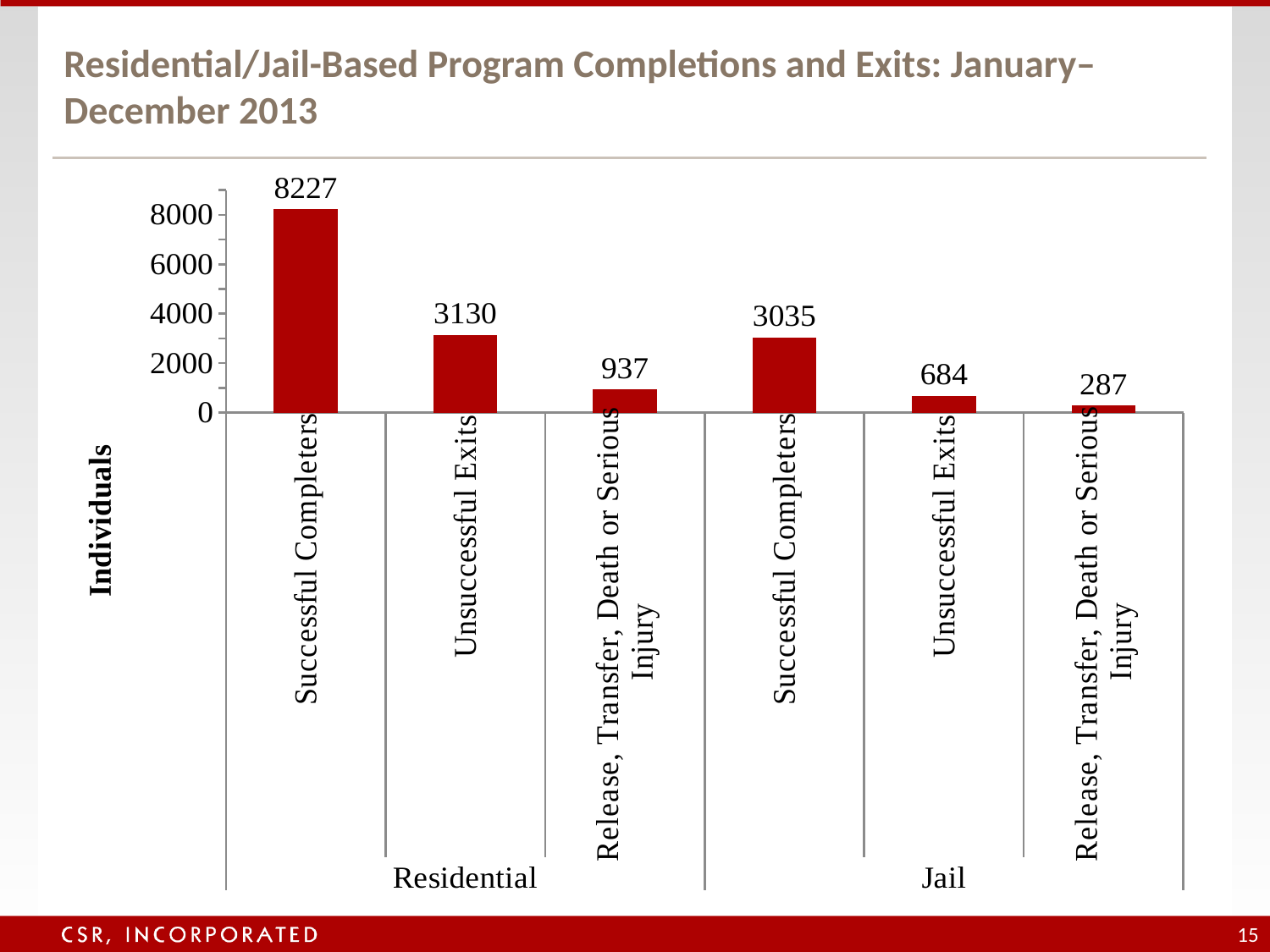
Which bar has the lowest value? Jail Release, Transfer, Death or Serious Injury Is the value for Release, Transfer, Death or Serious Injury in the Jail group greater or less than 2000? less Which is larger: Unsuccessful Exits in the Residential group or Successful Completers in the Jail group? Unsuccessful Exits in the Residential group What is the value for Release, Transfer, Death or Serious Injury in the Residential group? 937 What is the label on the vertical axis? Individuals Which bar has the highest value? Residential Successful Completers What is the value for Successful Completers in the Residential group? 8227 What kind of chart is shown on the slide? bar chart What is the value for Unsuccessful Exits in the Jail group? 684 How many bars are plotted in the chart? 6 What is the difference between Successful Completers in the Residential group and Successful Completers in the Jail group? 5192 What is the difference between Unsuccessful Exits in the Residential group and Unsuccessful Exits in the Jail group? 2446